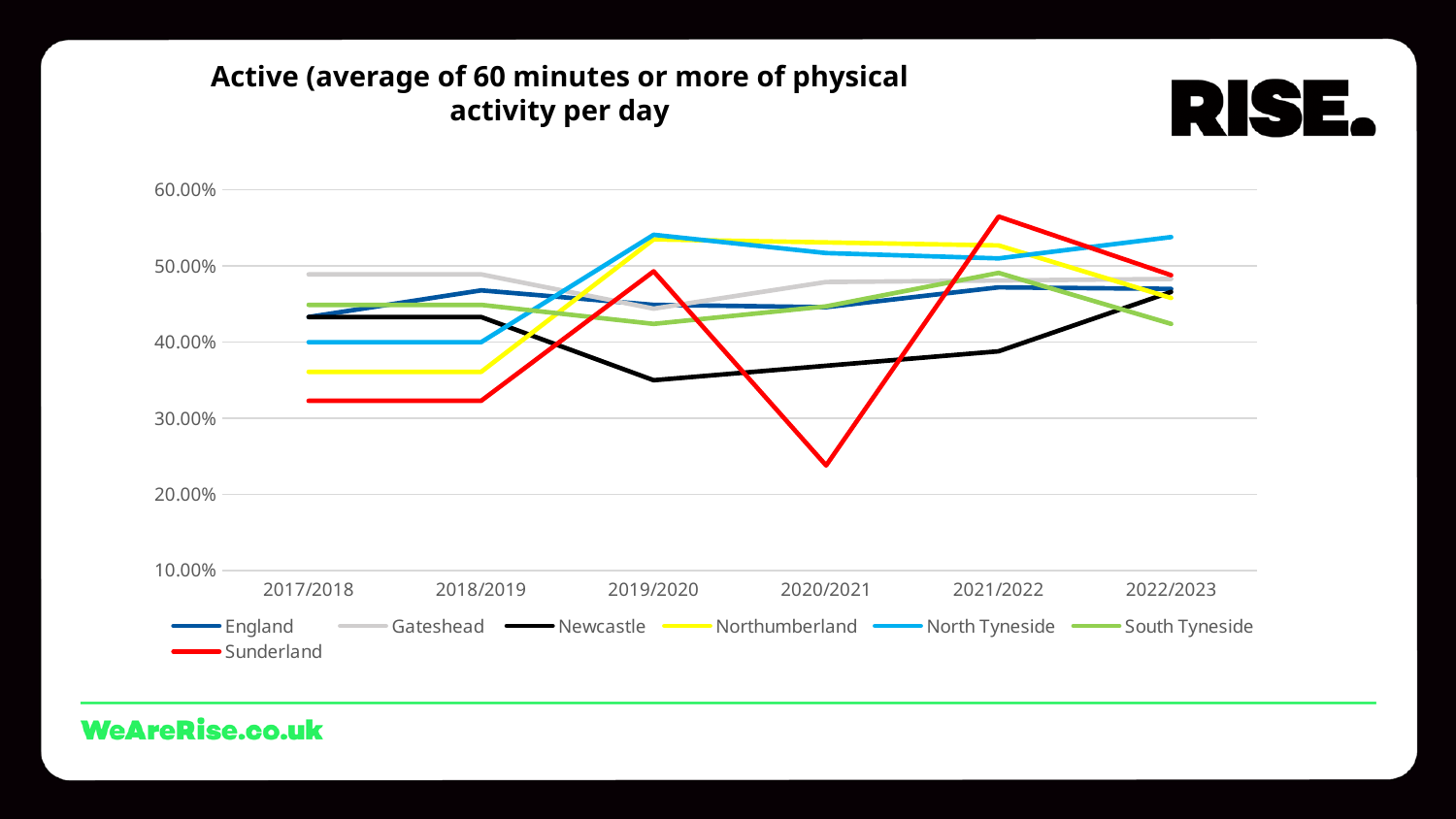
Is the value for Sunderland in 2020/2021 greater or less than 30.00%? less Which area has the lowest value in 2019/2020? Newcastle Is the value for Sunderland in 2021/2022 greater or less than 50.00%? greater How many time periods are shown on the x axis? 6 Which area has the lowest value in 2020/2021? Sunderland Which is larger in 2020/2021, the value for Newcastle or the value for Sunderland? Newcastle What kind of chart is shown on the slide? Line chart Which area has the highest value in 2022/2023? North Tyneside Which area has the highest value in 2021/2022? Sunderland How many series does the legend list? 7 What colour is the Sunderland line? Red Is the value for Newcastle in 2019/2020 greater or less than 40.00%? less